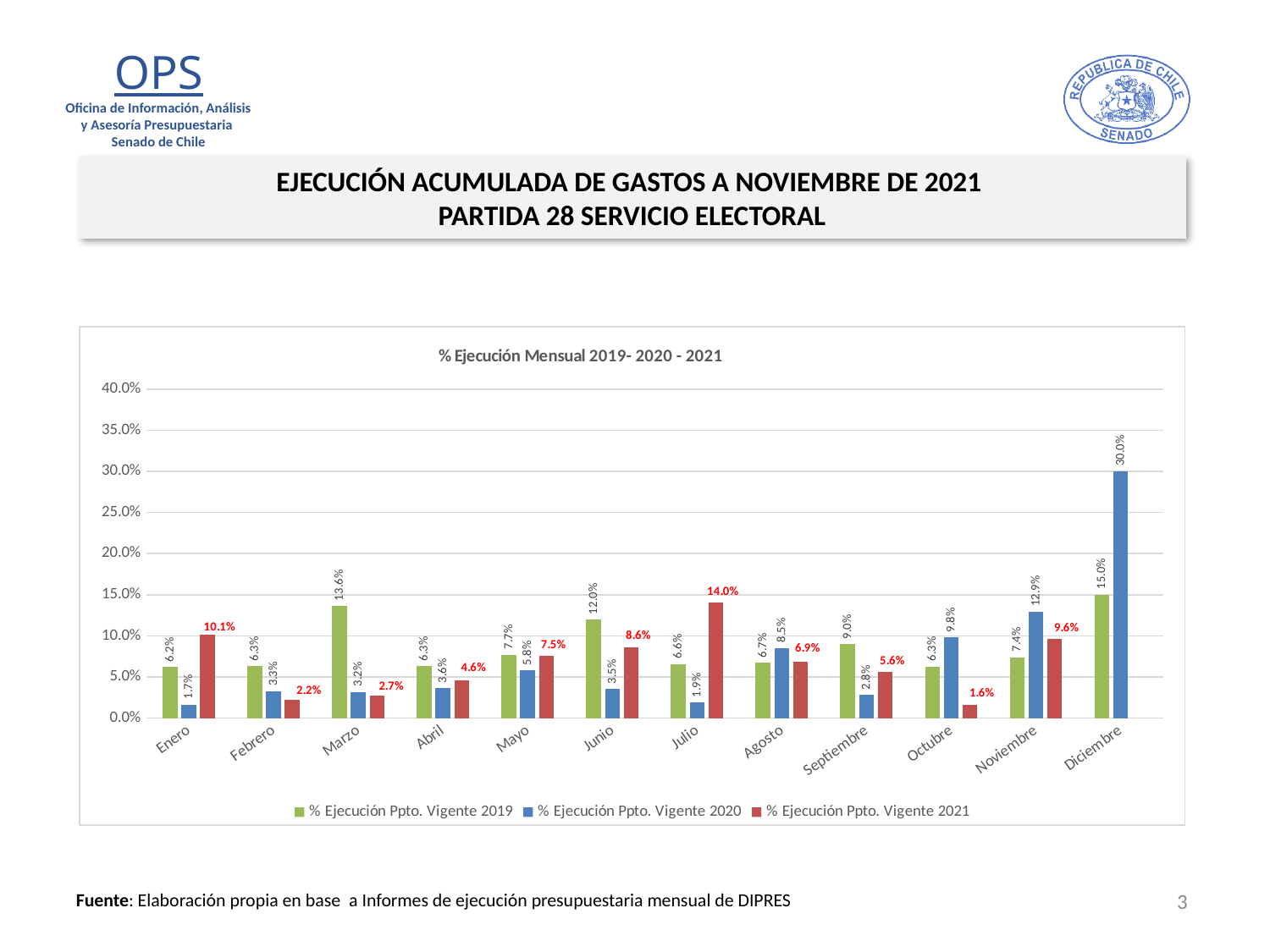
In which month is the % Ejecución Ppto. Vigente 2019 value highest? Diciembre In which month is the % Ejecución Ppto. Vigente 2021 value lowest? Octubre Is the value for % Ejecución Ppto. Vigente 2020 in Diciembre greater or less than 25.0%? greater What is the value for % Ejecución Ppto. Vigente 2019 in Marzo? 13.6% What is the difference between the 2021 and 2020 values in Enero? 8.4% How many series does the legend list? 3 What is the value for % Ejecución Ppto. Vigente 2020 in Diciembre? 30.0% What kind of chart is shown? Bar chart What is the value for % Ejecución Ppto. Vigente 2021 in Julio? 14.0% Which is larger in Agosto: the 2019 value or the 2020 value? 2020 value What is the title of the chart? % Ejecución Mensual 2019- 2020 - 2021 How many months are shown on the x axis? 12